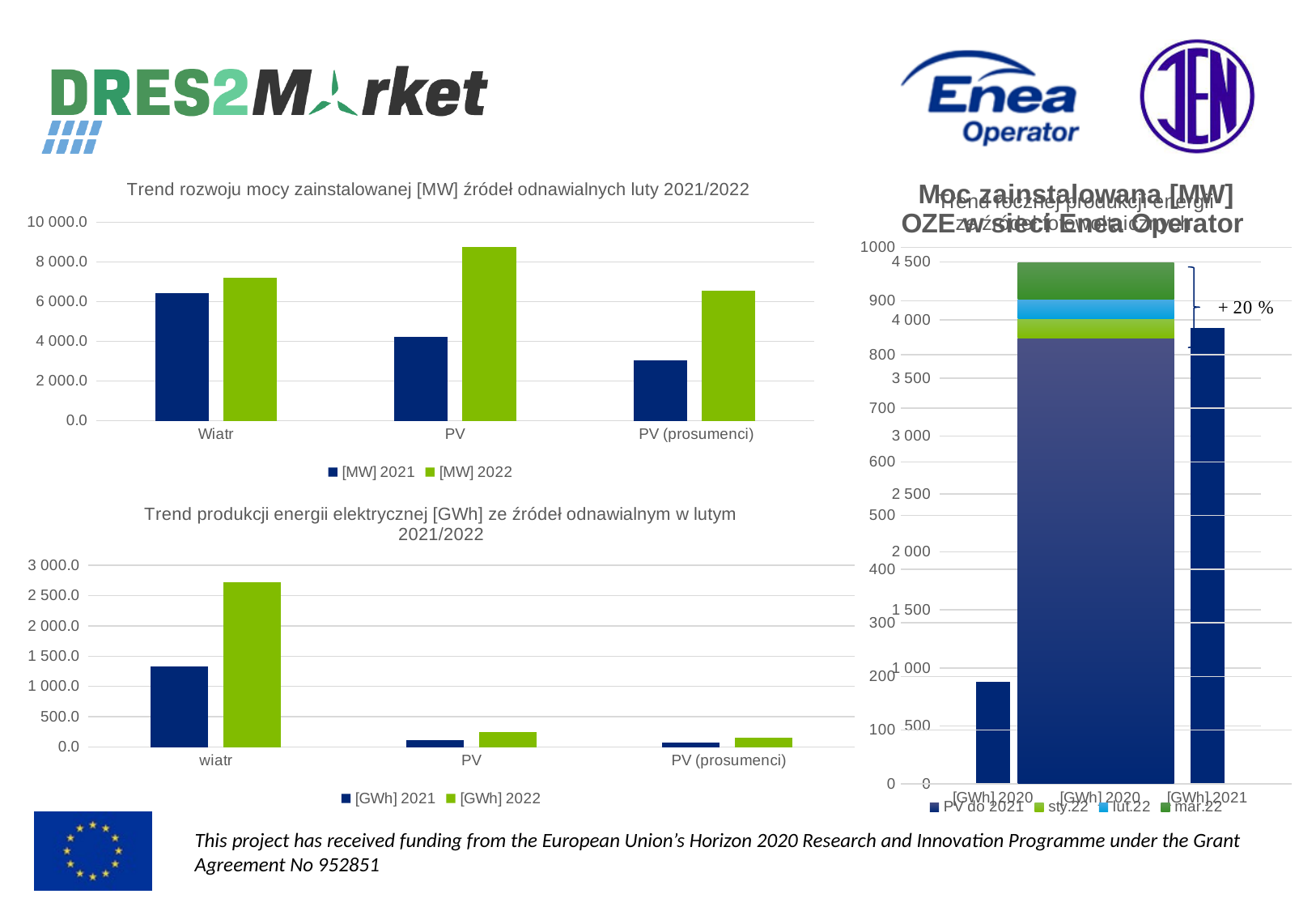
In the top-left chart (Trend rozwoju mocy zainstalowanej [MW]), what are the two legend entries? [MW] 2021 and [MW] 2022 In the top-left chart (Trend rozwoju mocy zainstalowanej [MW]), how many categories are shown on the x axis? 3 In the bottom-left chart (Trend produkcji energii elektrycznej [GWh]), how many series does the legend list? 2 In the top-left chart (Trend rozwoju mocy zainstalowanej [MW]), which is larger for [MW] 2021: Wiatr or PV? Wiatr In the top-left chart (Trend rozwoju mocy zainstalowanej [MW]), how many series does the legend list? 2 In the top-left chart (Trend rozwoju mocy zainstalowanej [MW]), which category has the highest [MW] 2022 value? PV What kind of chart is the top-left chart titled 'Trend rozwoju mocy zainstalowanej [MW] źródeł odnawialnych luty 2021/2022'? bar chart In the top-left chart (Trend rozwoju mocy zainstalowanej [MW]), is the [MW] 2022 value for PV greater or less than 8 000.0? greater In the bottom-left chart (Trend produkcji energii elektrycznej [GWh]), which is larger for wiatr: [GWh] 2021 or [GWh] 2022? [GWh] 2022 In the bottom-left chart (Trend produkcji energii elektrycznej [GWh]), which category has the highest [GWh] 2022 value? wiatr In the bottom-left chart (Trend produkcji energii elektrycznej [GWh]), is the [GWh] 2022 value for wiatr greater or less than 2 500.0? greater In the stacked bar chart on the right (Moc zainstalowana [MW] OZE w sieci Enea Operator), how many series does the legend list? 4